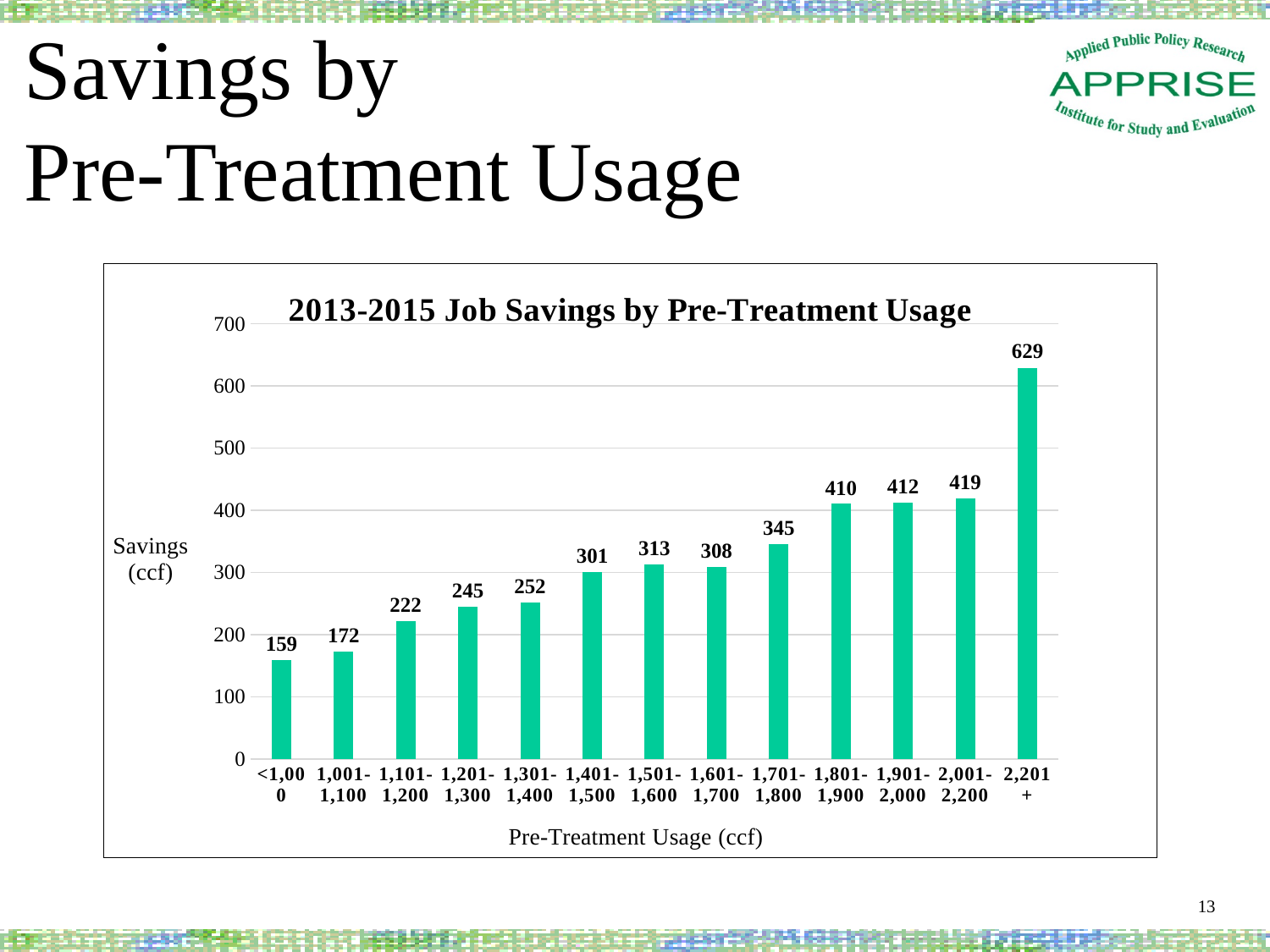
What is the difference in savings between the 2,201+ category and the 2,001-2,200 category? 210 Which pre-treatment usage category has the lowest savings? <1,000 Which pre-treatment usage category has the highest savings? 2,201+ What kind of chart is shown on the slide? Bar chart How many pre-treatment usage categories are shown in the chart? 13 What is the savings value for the <1,000 pre-treatment usage category? 159 What is the title of the chart? 2013-2015 Job Savings by Pre-Treatment Usage What is the savings value for the 1,401-1,500 pre-treatment usage category? 301 What is the savings value for the 2,201+ pre-treatment usage category? 629 Which has higher savings: the 1,501-1,600 category or the 1,601-1,700 category? 1,501-1,600 Do savings generally rise or fall as pre-treatment usage increases along the x axis? Rise Is the savings value for the 1,701-1,800 category greater or less than 400? less